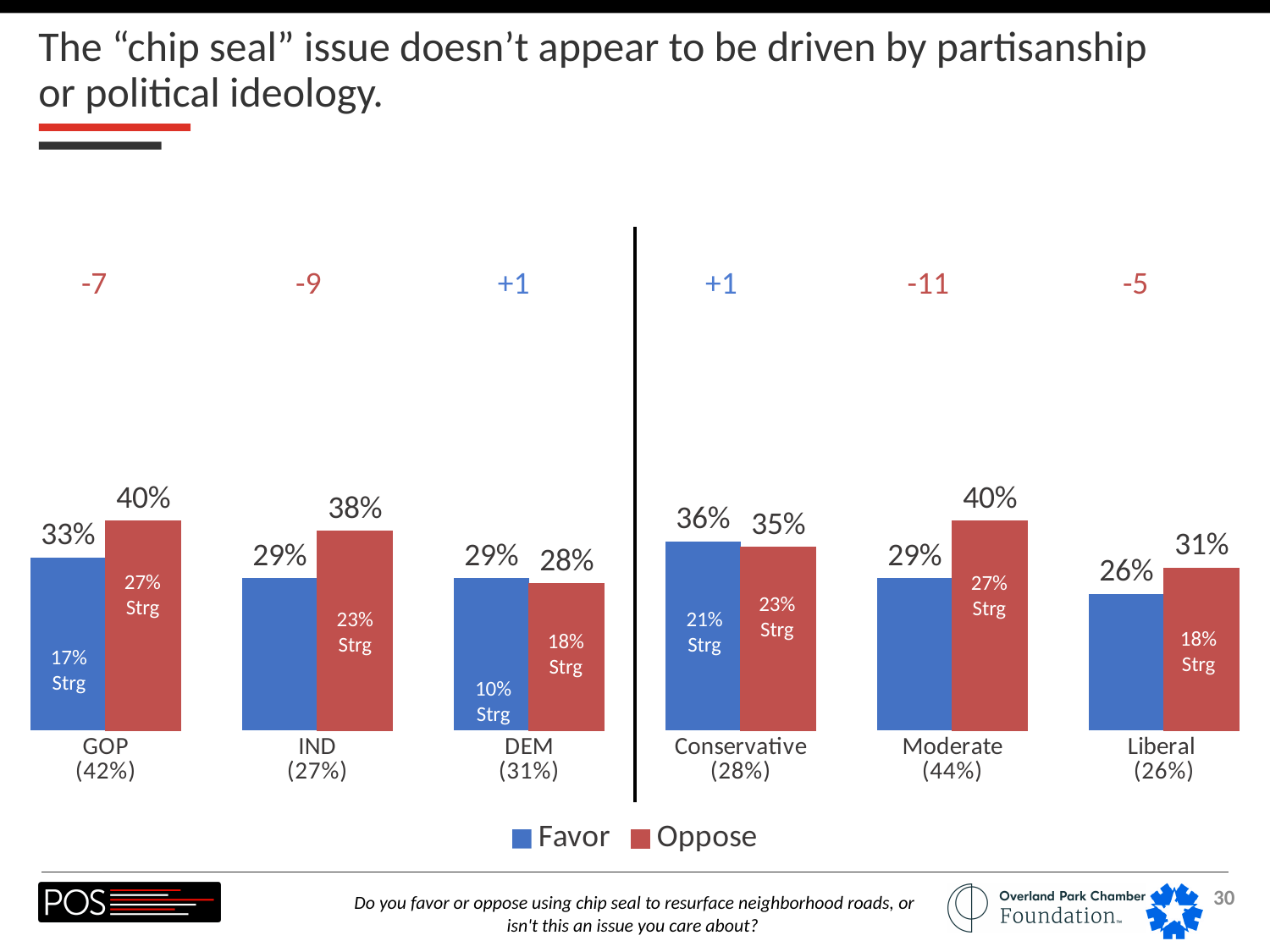
How many series does the legend list? 2 What kind of chart is shown on the slide? Bar chart Which group has the highest Favor percentage? Conservative How many groups are shown along the x axis? 6 What share of the sample is labeled as GOP on the x axis? 42% What is the 'Strg' (strongly) favor percentage shown inside the DEM Favor bar? 10% What percentage of GOP respondents favor using chip seal? 33% For Conservative respondents, is the Favor or Oppose percentage larger? Favor What percentage of Moderate respondents oppose using chip seal? 40% What net figure is shown above the Moderate group? -11 What is the difference between the Oppose and Favor percentages for IND? 9 percentage points Which group has the lowest Favor percentage? Liberal